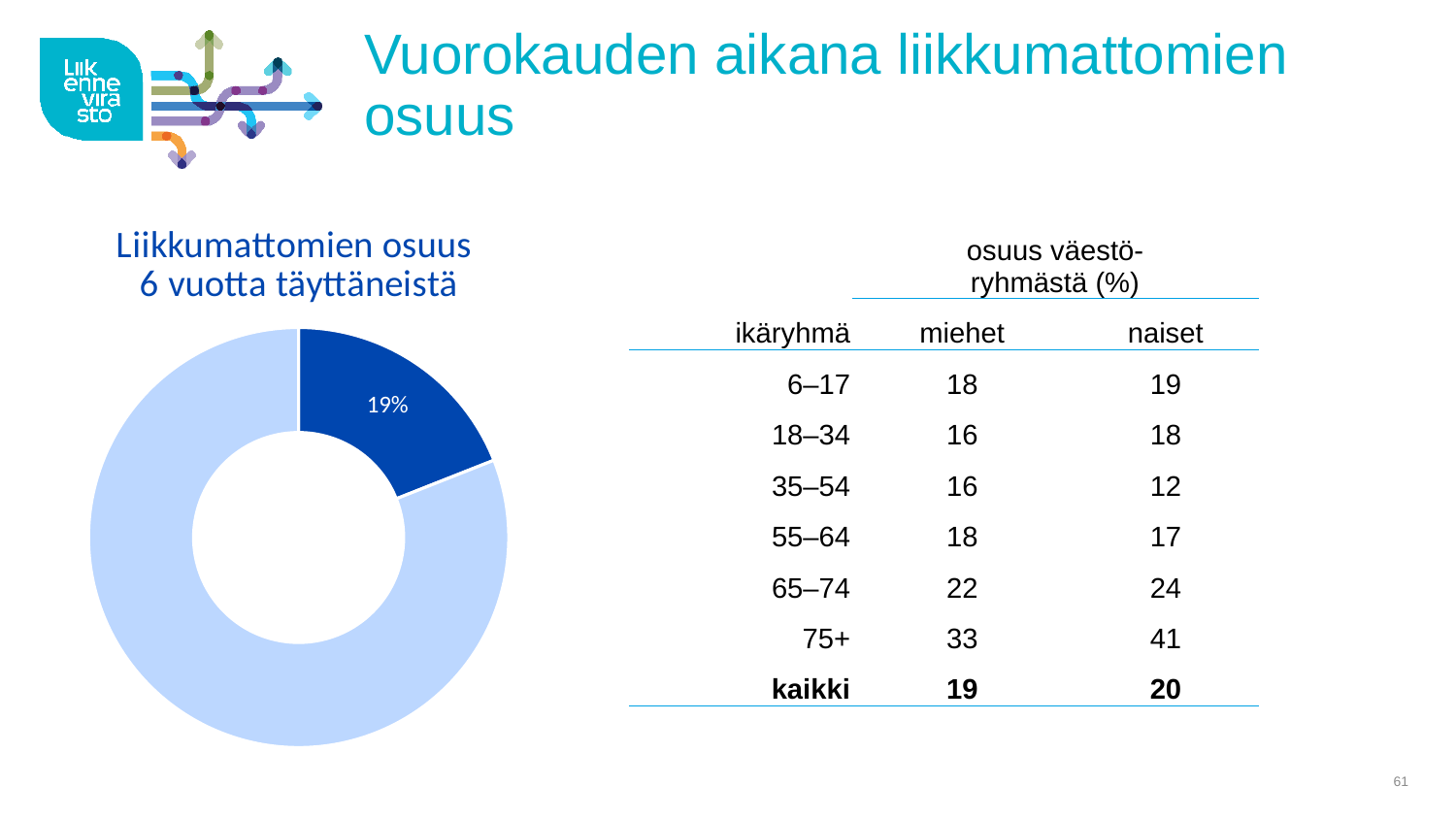
Which slice of the doughnut chart is larger, the dark blue one or the light blue one? the light blue one How many slices does the doughnut chart have? 2 Is the value of the dark blue slice in the doughnut chart greater or less than 50%? less What share of the doughnut chart does the dark blue slice represent? 19% What colour is the slice of the doughnut chart that carries the 19% label? dark blue What is the title of the doughnut chart? Liikkumattomien osuus 6 vuotta täyttäneistä What value is printed on the dark blue slice of the doughnut chart? 19% What kind of chart is shown on the left of the slide? doughnut (pie) chart